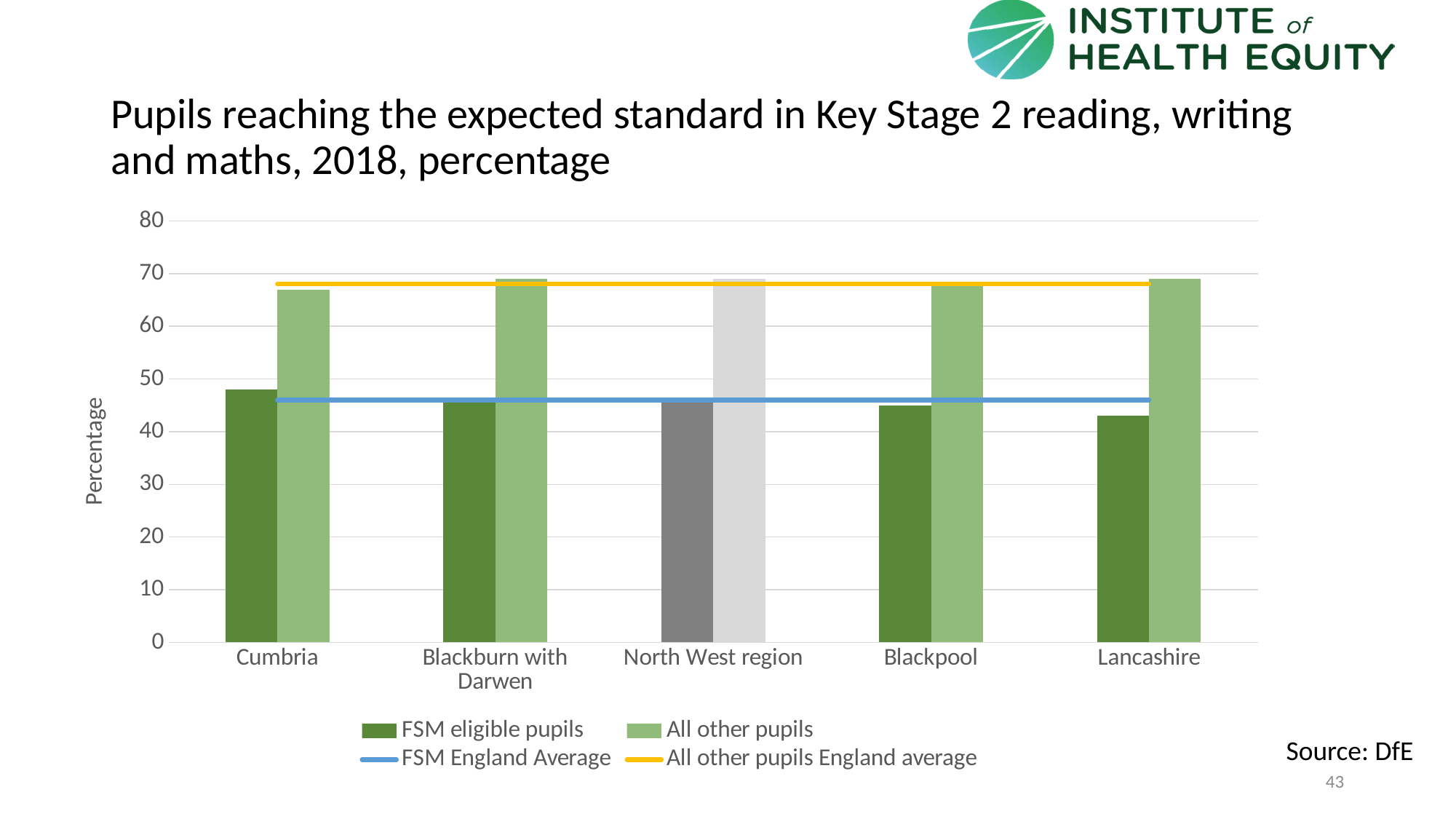
What kind of chart is shown on the slide? combination bar and line chart Is the value for All other pupils in Cumbria greater or less than 70? less What is the label on the vertical axis? Percentage In Blackpool, which is larger: the value for FSM eligible pupils or for All other pupils? All other pupils Is the value for FSM eligible pupils in Cumbria greater or less than 40? greater How many categories are shown on the x axis? 5 Is the value for All other pupils in Lancashire greater or less than 60? greater Which is larger: the FSM eligible pupils value for Cumbria or for Lancashire? Cumbria How many series does the legend list? 4 Which category has the lowest value for FSM eligible pupils? Lancashire Which category has the highest value for FSM eligible pupils? Cumbria